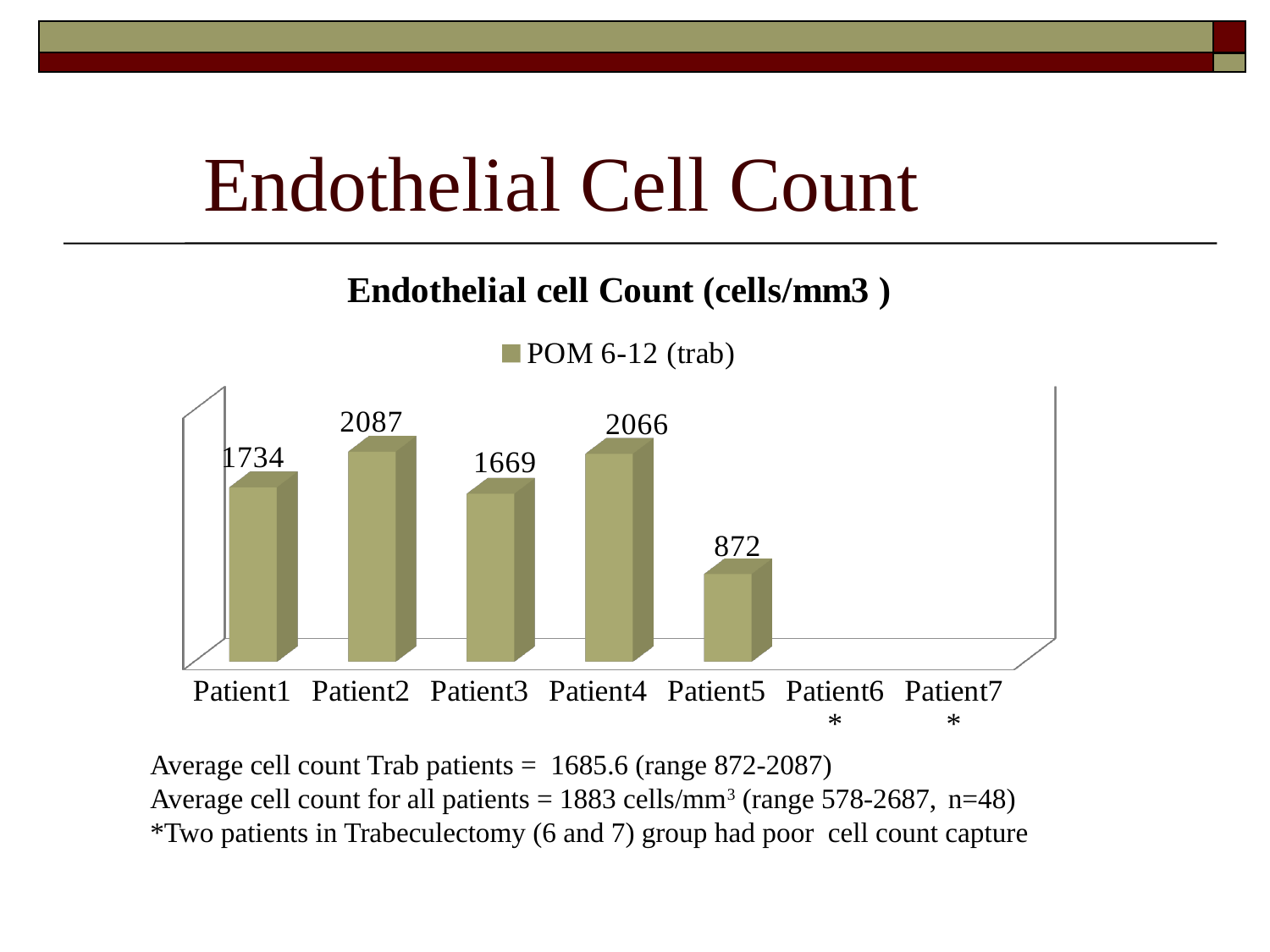
What is the endothelial cell count for Patient3? 1669 What is the endothelial cell count for Patient1? 1734 What is the endothelial cell count for Patient2? 2087 How many patients have a bar plotted in the chart? 5 Which patient has the highest endothelial cell count? Patient2 What is the difference between the cell counts of Patient1 and Patient3? 65 Which has a higher cell count, Patient4 or Patient1? Patient4 How many series does the legend list? 1 What is the endothelial cell count for Patient5? 872 What is the difference between the cell counts of Patient2 and Patient5? 1215 What type of chart is shown on the slide? Bar chart Which patient with a plotted bar has the lowest endothelial cell count? Patient5